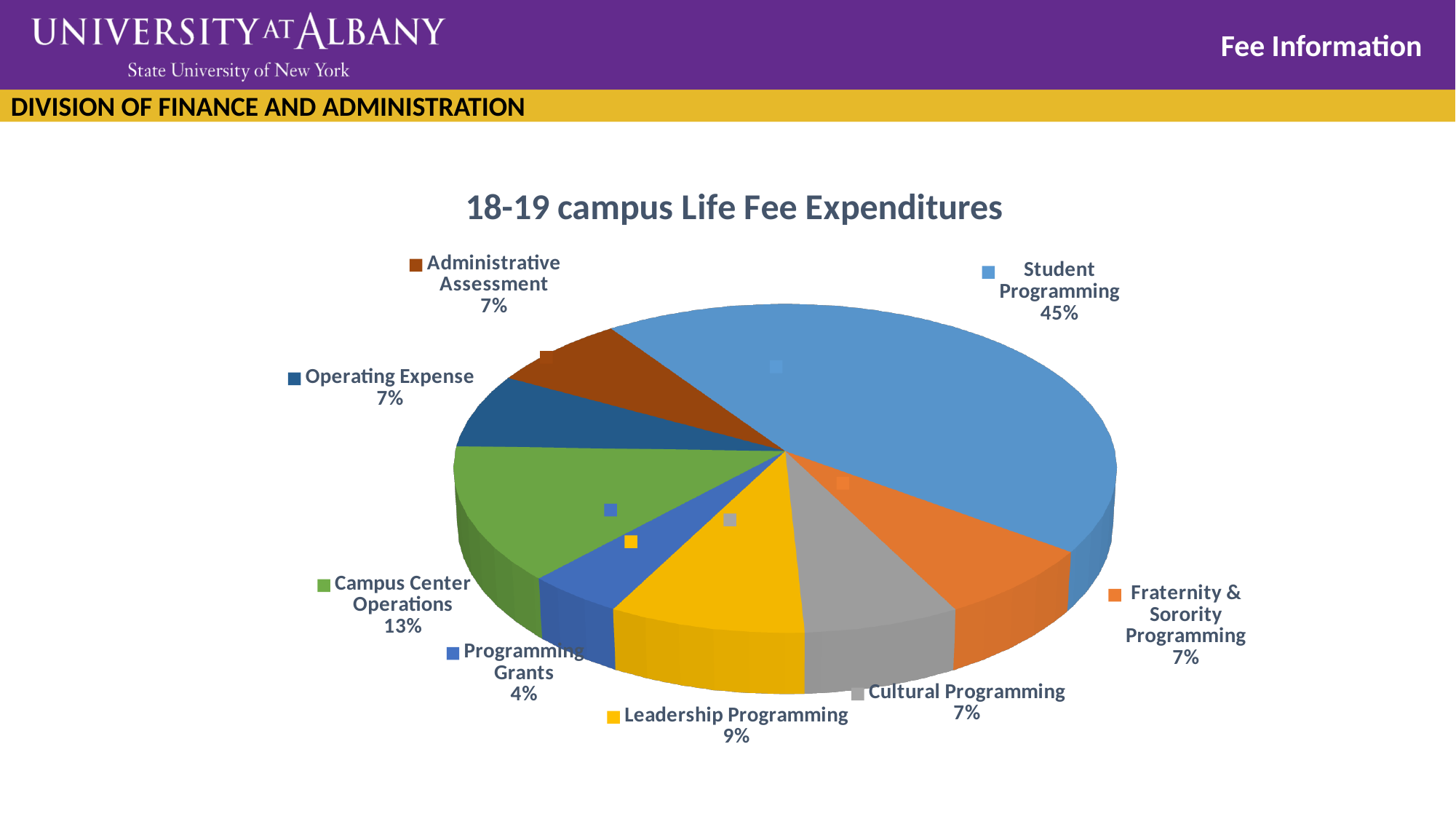
What percentage is shown for Campus Center Operations? 13% What percentage is shown for Operating Expense? 7% Which is larger, Leadership Programming or Cultural Programming? Leadership Programming What percentage is shown for Programming Grants? 4% Which category has the largest share of the pie? Student Programming What percentage is shown for Leadership Programming? 9% Which category has the smallest share of the pie? Programming Grants What is the title of the chart? 18-19 campus Life Fee Expenditures What share of the pie does Student Programming represent? 45% What kind of chart is shown on the slide? Pie chart How many categories are shown in the pie chart? 8 What is the difference in percentage points between Student Programming and Campus Center Operations? 32